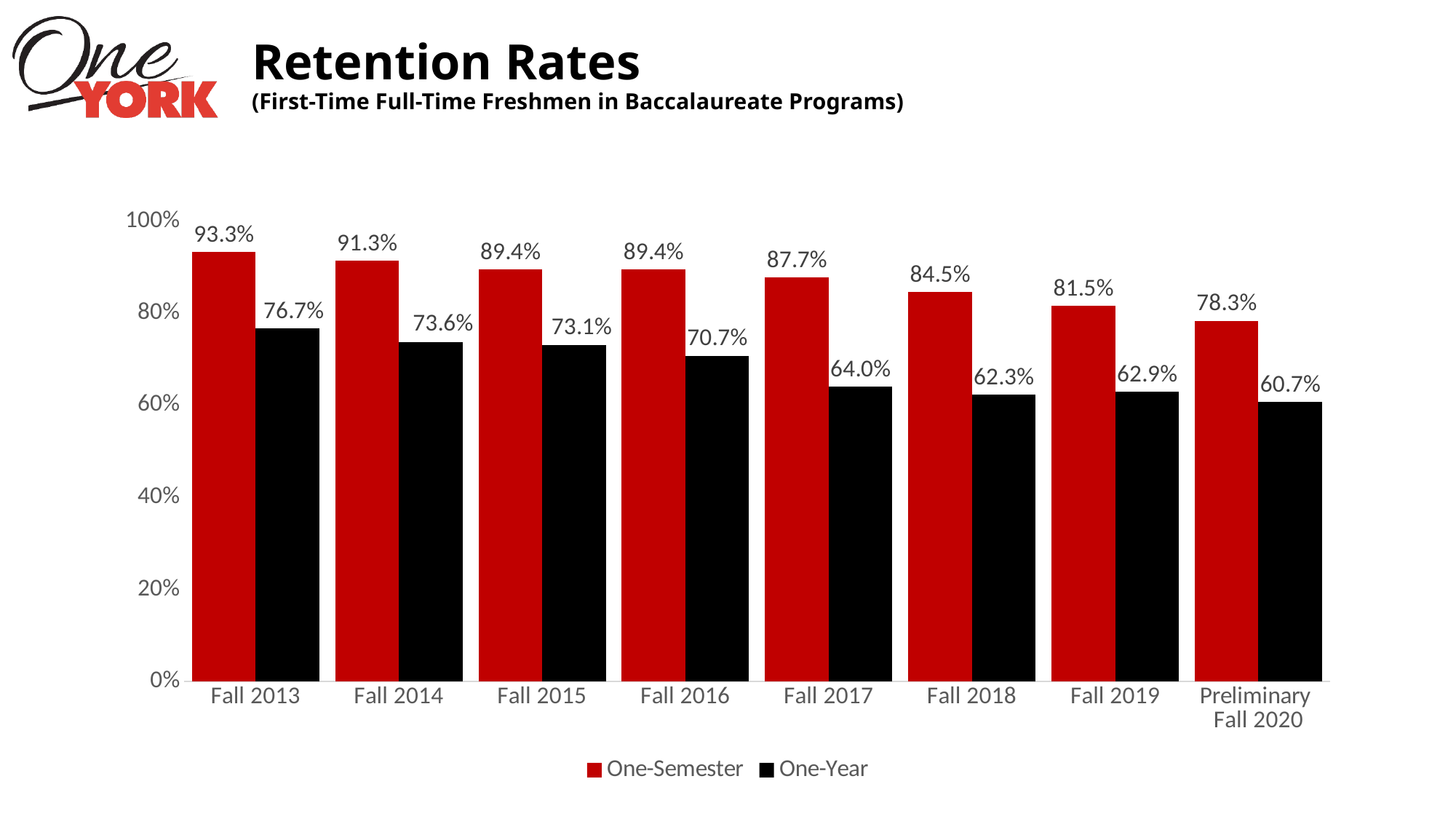
Which category has the highest One-Semester retention rate? Fall 2013 Which category has the lowest One-Year retention rate? Preliminary Fall 2020 How many series does the legend list? 2 Which is larger, the One-Year retention rate for Fall 2018 or for Fall 2019? Fall 2019 What kind of chart is shown on the slide? Bar chart What colour are the One-Year bars? Black What is the One-Semester retention rate for Fall 2013? 93.3% What is the One-Year retention rate for Fall 2017? 64.0% Do the One-Semester retention rates rise or fall from Fall 2013 to Preliminary Fall 2020? Fall What is the difference between the One-Semester and One-Year retention rates for Fall 2016? 18.7% What is the One-Year retention rate for Preliminary Fall 2020? 60.7% How many categories are shown on the x axis? 8